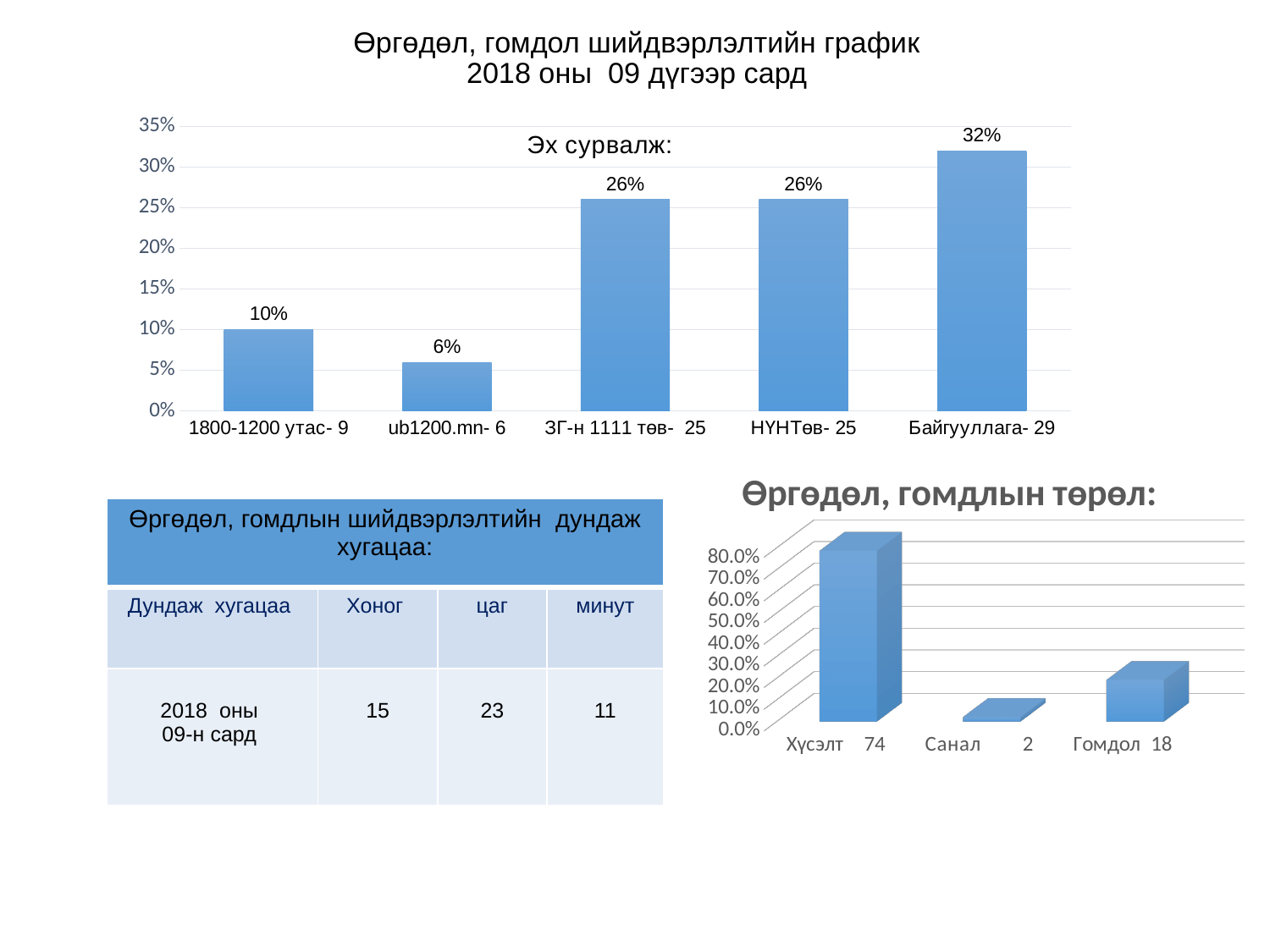
In the chart titled "Эх сурвалж:", what is the value for "Байгууллага- 29"? 32% In the chart titled "Өргөдөл, гомдлын төрөл:", is the value for "Хүсэлт" greater or less than 70.0%? greater In the chart titled "Эх сурвалж:", what is the value for "1800-1200 утас- 9"? 10% In the chart titled "Өргөдөл, гомдлын төрөл:", which category has the lowest value? Санал In the chart titled "Эх сурвалж:", which is larger, the value for "1800-1200 утас- 9" or the value for "ub1200.mn- 6"? 1800-1200 утас- 9 In the chart titled "Эх сурвалж:", what is the difference between the values for "Байгууллага- 29" and "ЗГ-н 1111 төв- 25"? 6% In the chart titled "Эх сурвалж:", what is the value for "ub1200.mn- 6"? 6% In the chart titled "Өргөдөл, гомдлын төрөл:", is the value for "Гомдол" greater or less than 30.0%? less In the chart titled "Эх сурвалж:", which category has the highest value? Байгууллага- 29 In the chart titled "Эх сурвалж:", which category has the lowest value? ub1200.mn- 6 What kind of chart is the chart titled "Өргөдөл, гомдлын төрөл:"? bar chart How many categories are shown in the chart titled "Эх сурвалж:"? 5